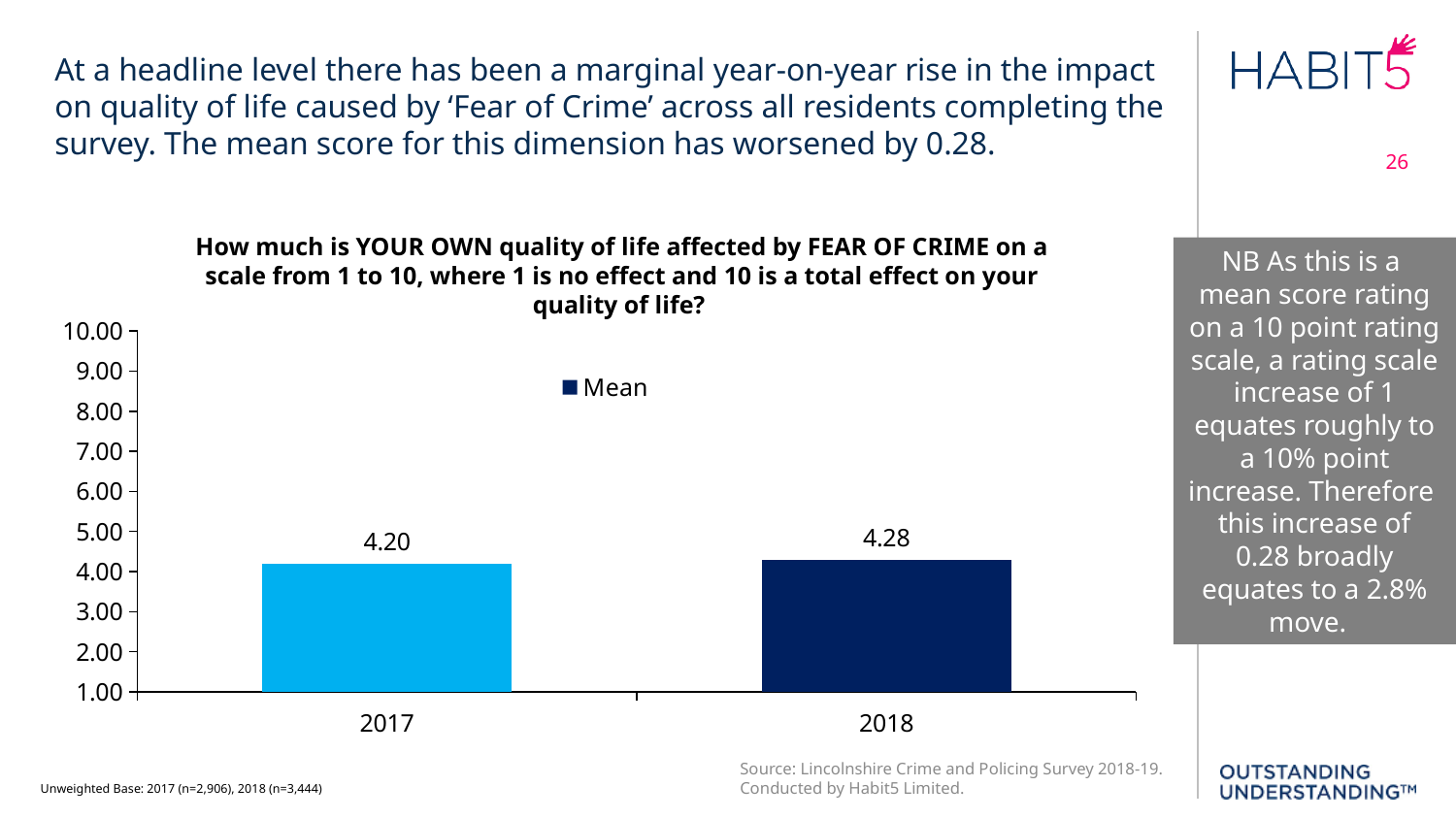
How many series does the legend list? 1 How many years are shown on the x axis? 2 Does the mean score rise or fall from 2017 to 2018? rise What is the name of the series shown in the legend? Mean What is the mean score for 2018? 4.28 Is the mean score for 2018 greater or less than 4.00? greater What is the difference between the 2018 and 2017 mean scores? 0.08 Is the mean score for 2017 greater or less than 5.00? less Which year has the lower mean score? 2017 What is the mean score for 2017? 4.20 Which year has the higher mean score? 2018 What kind of chart is shown? bar chart